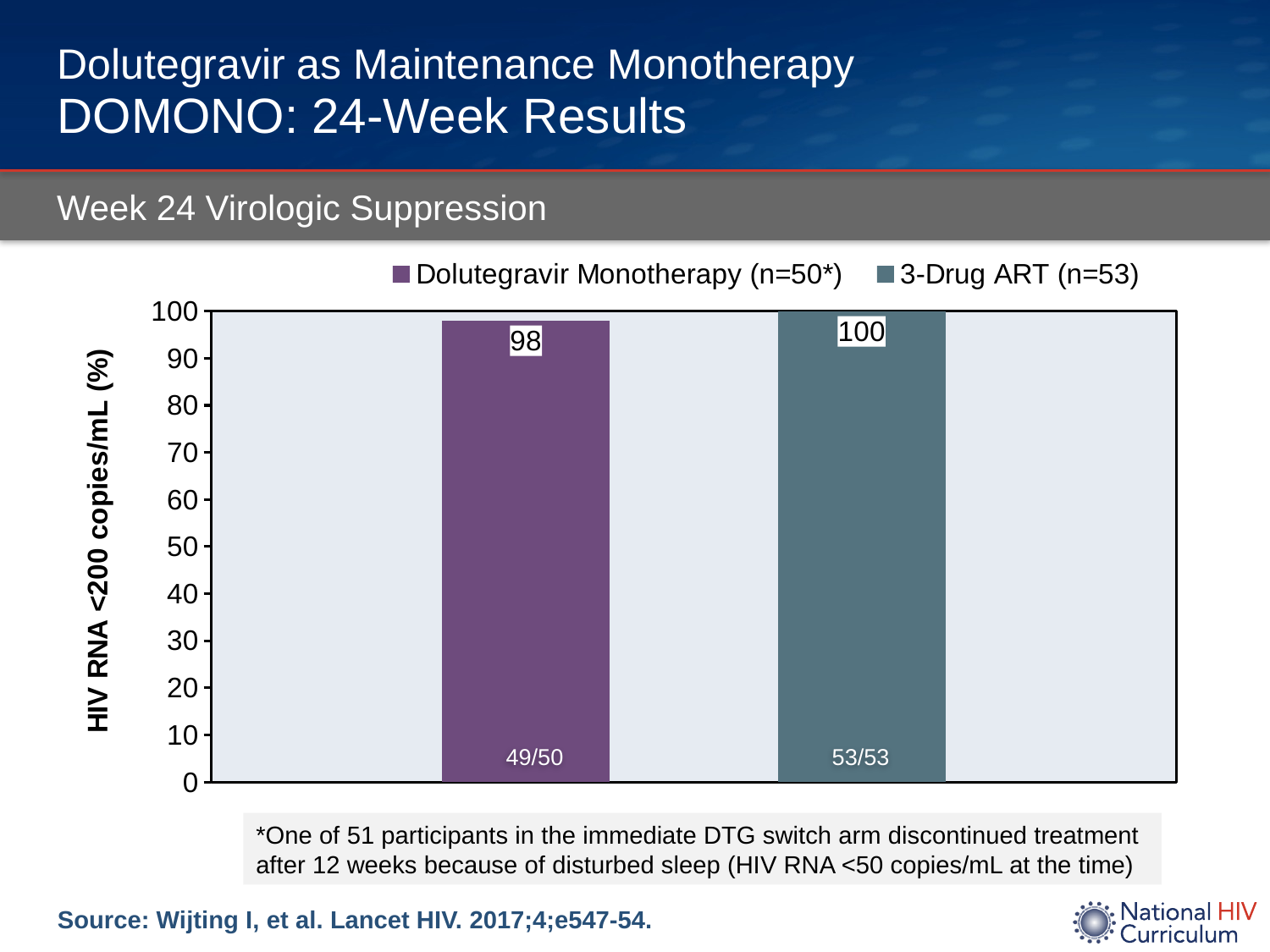
What kind of chart is shown? Bar chart How many series does the legend list? 2 What is the value for Dolutegravir Monotherapy (n=50*)? 98 What is the value for 3-Drug ART (n=53)? 100 What is the difference between the 3-Drug ART value and the Dolutegravir Monotherapy value? 2 Which group has the lower value? Dolutegravir Monotherapy (n=50*) What is the y-axis label of the chart? HIV RNA <200 copies/mL (%) Which group has the higher value? 3-Drug ART (n=53) What fraction is printed at the base of the 3-Drug ART bar? 53/53 Is the value for Dolutegravir Monotherapy greater or less than 90? greater What fraction is printed at the base of the Dolutegravir Monotherapy bar? 49/50 What is the title shown above the chart? Week 24 Virologic Suppression